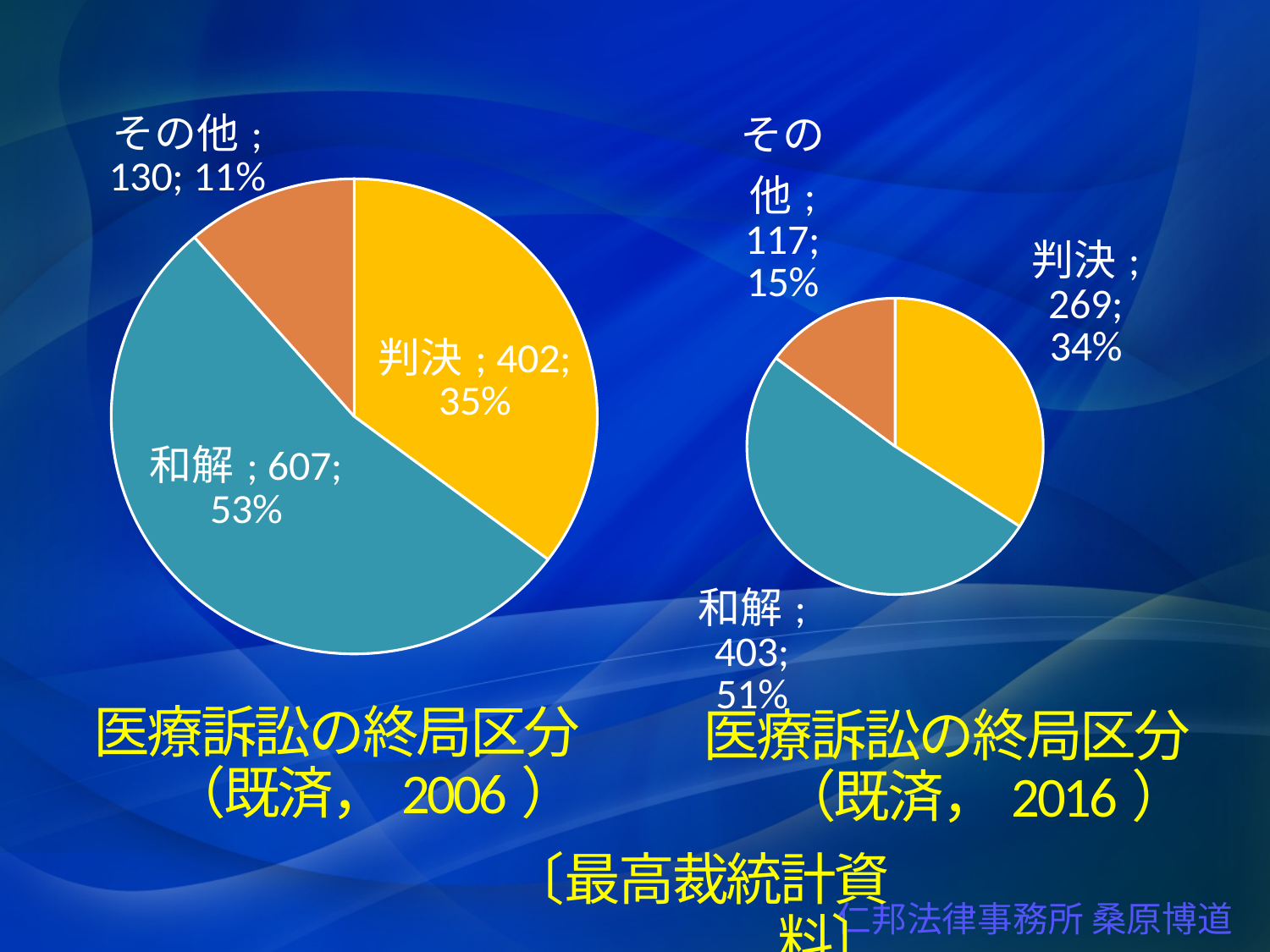
In the 2016 chart, what is the difference between the values for 判決 and その他? 152 What kind of chart is the left chart (2006)? Pie chart In the 2016 chart, what percentage share does その他 have? 15% In the 2006 chart (医療訴訟の終局区分（既済，2006）), what is the value for 和解? 607 How many categories does the 2016 chart show? 3 In the 2006 chart, which category is the largest? 和解 In the 2006 chart, what is the difference between the values for 和解 and 判決? 205 In the 2006 chart, what percentage share does 判決 have? 35% Which is larger: 和解 in the 2006 chart or 和解 in the 2016 chart? 和解 in the 2006 chart In the 2016 chart (医療訴訟の終局区分（既済，2016）), what is the value for 判決? 269 In the 2016 chart, which category is the smallest? その他 What is the title of the right chart? 医療訴訟の終局区分（既済，2016）